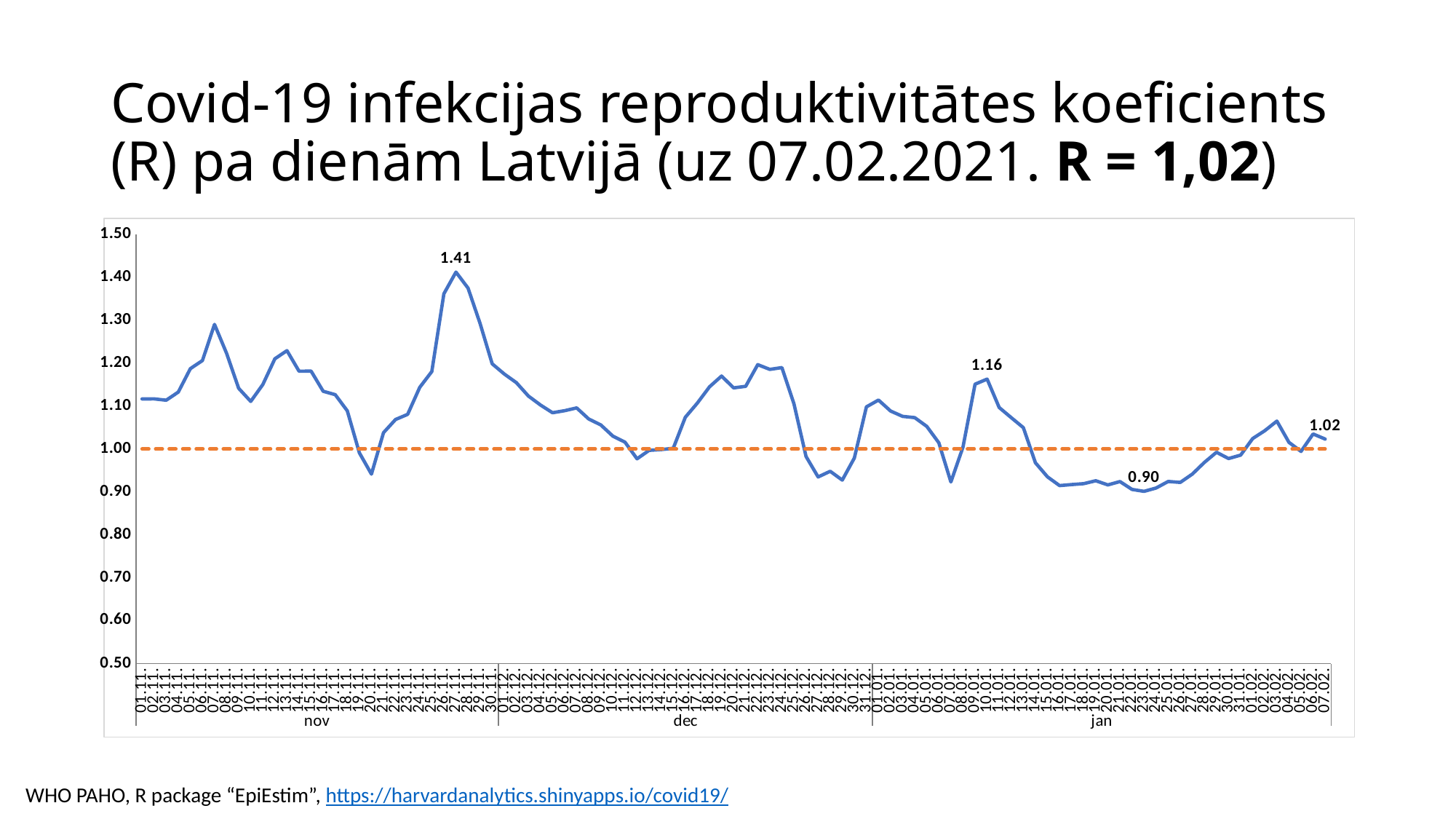
What is the R value labelled at the peak in January (around 10.01)? 1.16 What is the difference between the late-November peak (1.41) and the January peak (1.16)? 0.25 Is the R value on 20.11 greater or less than 1.00? less Does the R value rise or fall between 10.01 and 23.01? fall Which is larger, the late-November peak or the January peak? the late-November peak (1.41) What is the R value labelled at the end of the series, on 07.02? 1.02 What is the highest labelled value of the R coefficient on the chart? 1.41 Is the R value on 07.11 greater or less than 1.20? greater What kind of chart is shown on the slide? line chart What is the lowest labelled value of the R coefficient on the chart? 0.90 At what level is the dashed orange horizontal line drawn? 1.00 What is the difference between the January peak (1.16) and the January low (0.90)? 0.26